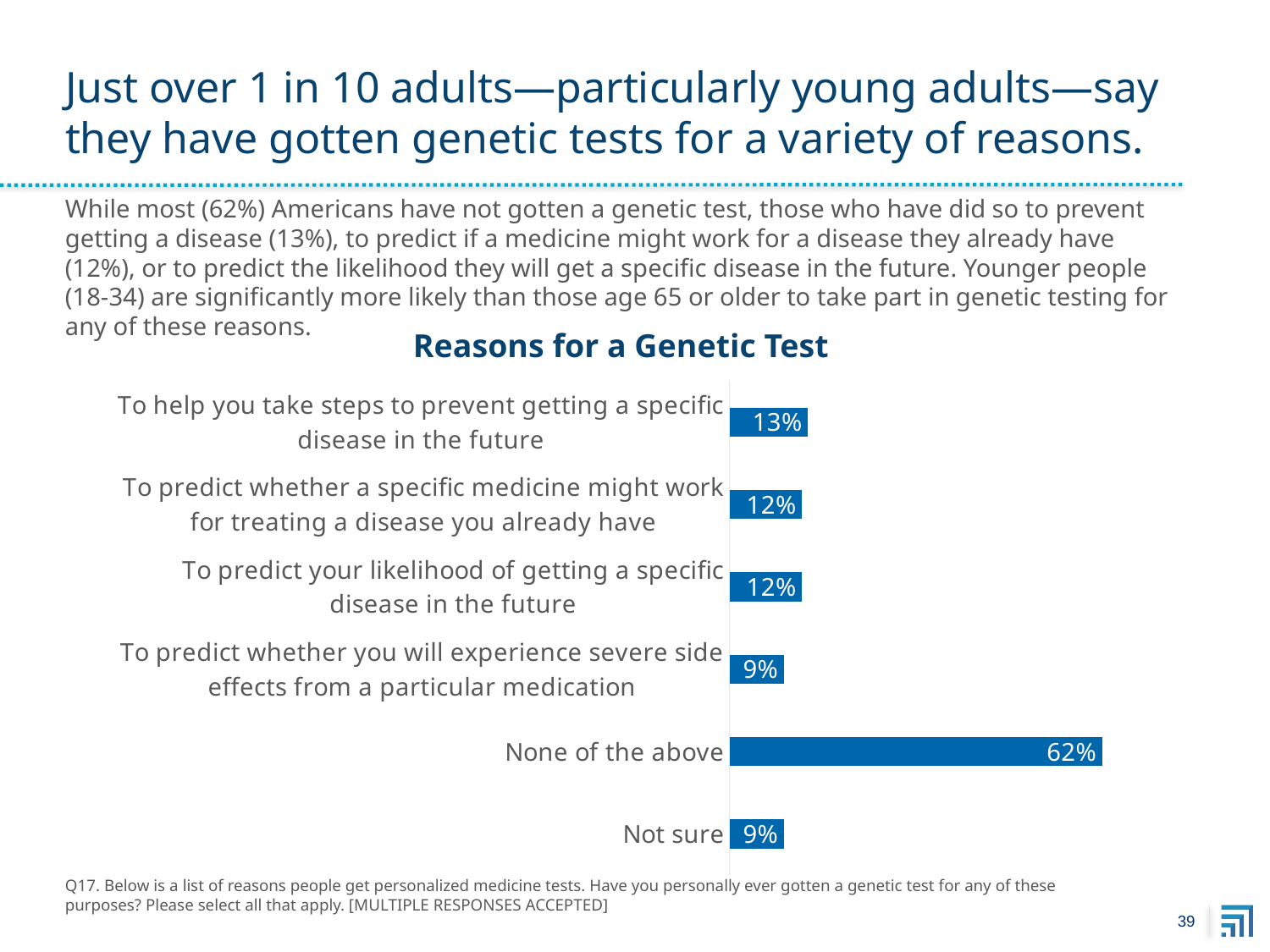
Which category has the highest value? None of the above What percentage say they got a genetic test to help take steps to prevent getting a specific disease in the future? 13% What is the difference between "None of the above" and "To help you take steps to prevent getting a specific disease in the future"? 49 percentage points What is the value for "To predict whether a specific medicine might work for treating a disease you already have"? 12% What is the value for "None of the above"? 62% How many categories are shown in the chart? 6 What is the title of the chart? Reasons for a Genetic Test What is the difference between the value for preventing a specific disease in the future and the value for predicting severe side effects from a particular medication? 4 percentage points What is the value for "Not sure"? 9% What kind of chart is shown on the slide? Bar chart What is the value for "To predict whether you will experience severe side effects from a particular medication"? 9% Which is larger: the value for "To help you take steps to prevent getting a specific disease in the future" or the value for "Not sure"? To help you take steps to prevent getting a specific disease in the future